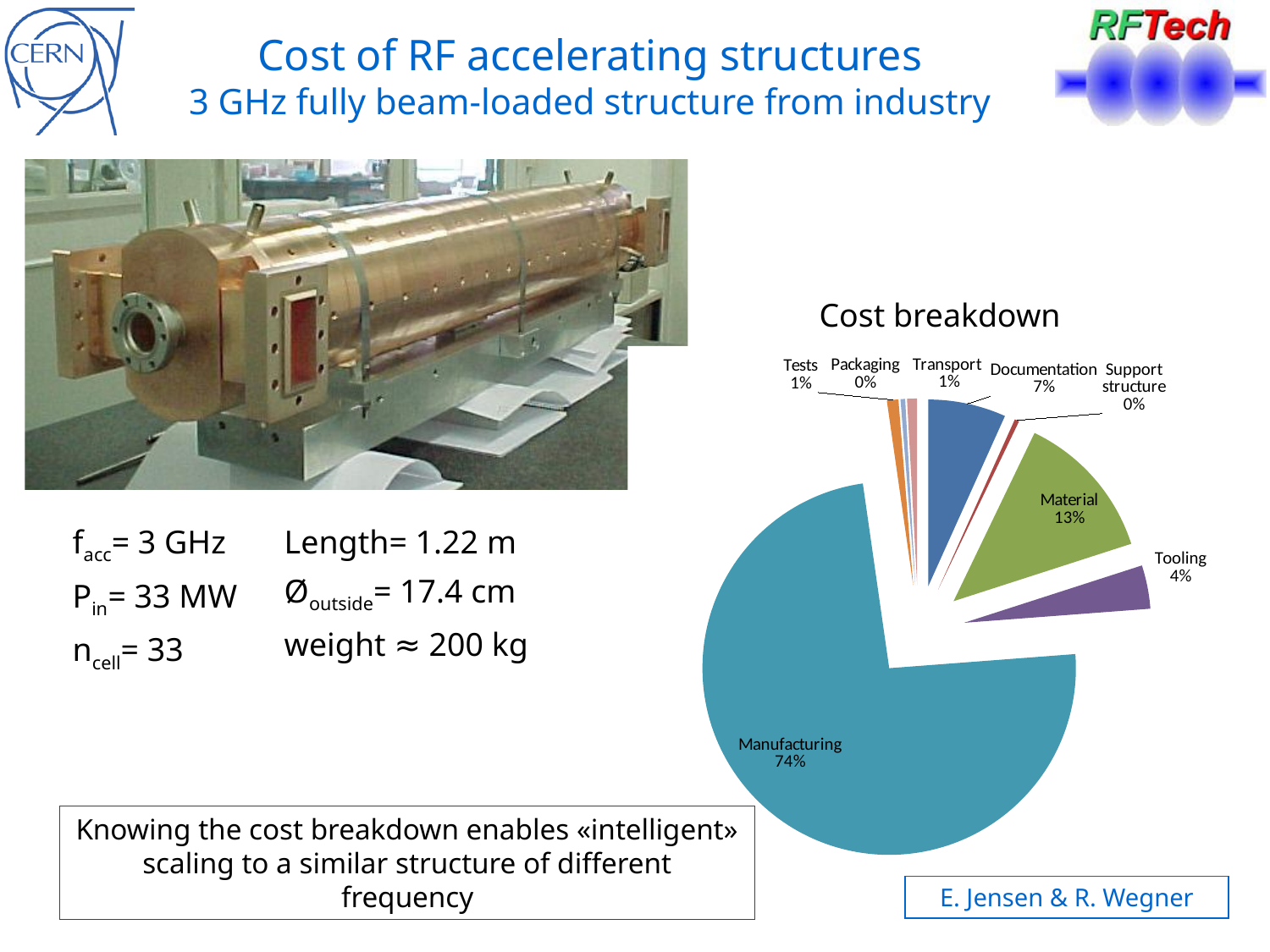
What share of the cost breakdown is Material? 13% What share of the cost breakdown is Tooling? 4% What is the difference between the Manufacturing share and the Material share in the cost breakdown? 61% What kind of chart is the "Cost breakdown" chart? pie chart What share of the cost breakdown is Transport? 1% What share of the cost breakdown is Manufacturing? 74% What share of the cost breakdown is Documentation? 7% Which category has the largest share in the cost breakdown pie chart? Manufacturing What is the title of the chart on the slide? Cost breakdown Which two categories in the cost breakdown are labelled 0%? Packaging and Support structure Which is larger in the cost breakdown, Material or Documentation? Material How many categories are shown in the cost breakdown pie chart? 8